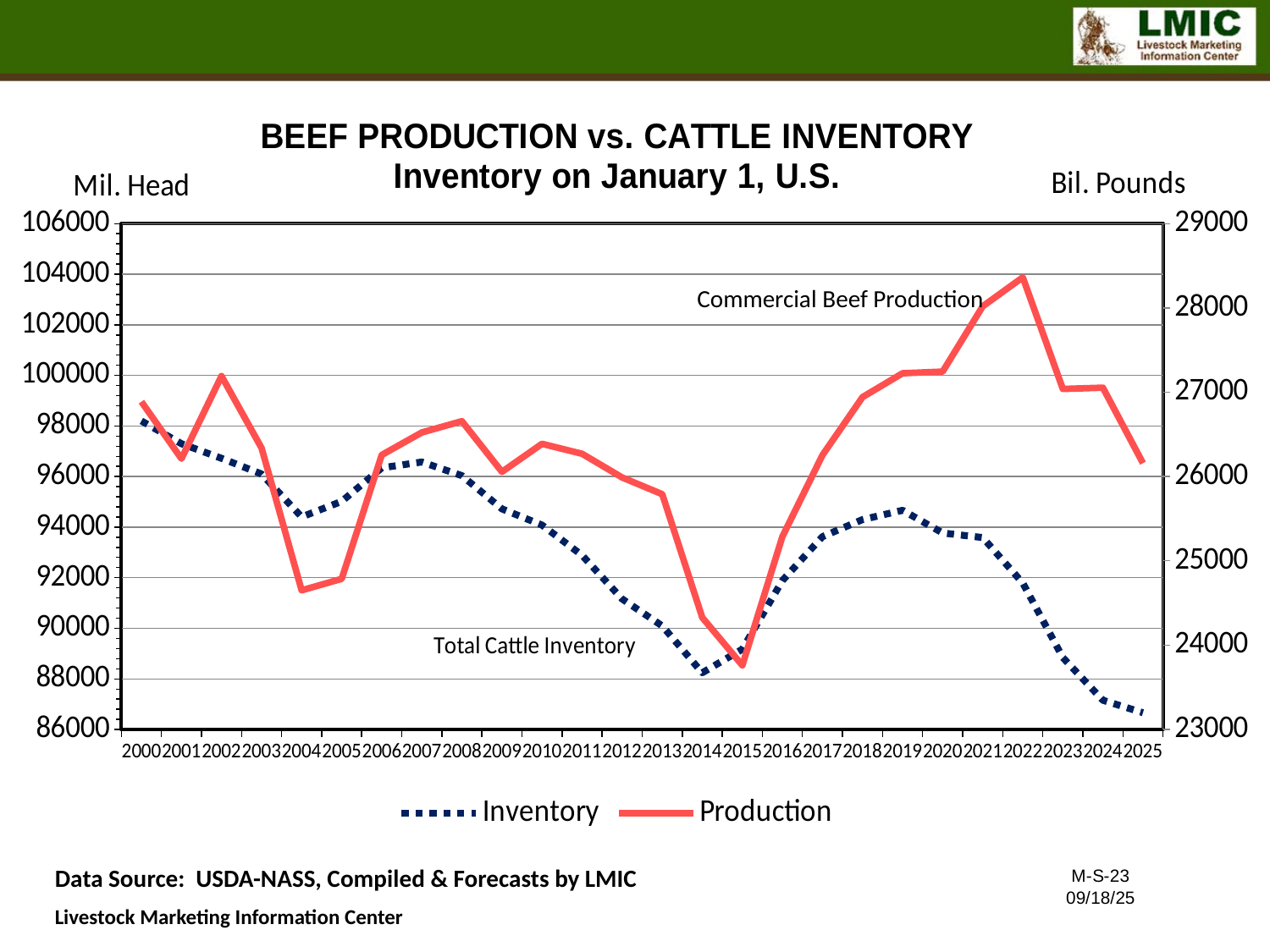
In which year is the Inventory series at its highest? 2000 In which year is the Production series at its highest? 2022 Is the Production value for 2022 greater or less than 28000 on the right axis? greater How many years are shown along the x axis? 26 How many series does the legend list? 2 Is the Inventory value for 2014 greater or less than 90000 on the left axis? less Is the Inventory value for 2025 greater or less than 88000 on the left axis? less Does the Inventory series rise or fall from 2019 to 2025? fall In which year is the Production series at its lowest? 2015 What kind of chart is shown on the slide? line chart In which year is the Inventory series at its lowest? 2025 Which axis label is shown on the right side of the chart? Bil. Pounds